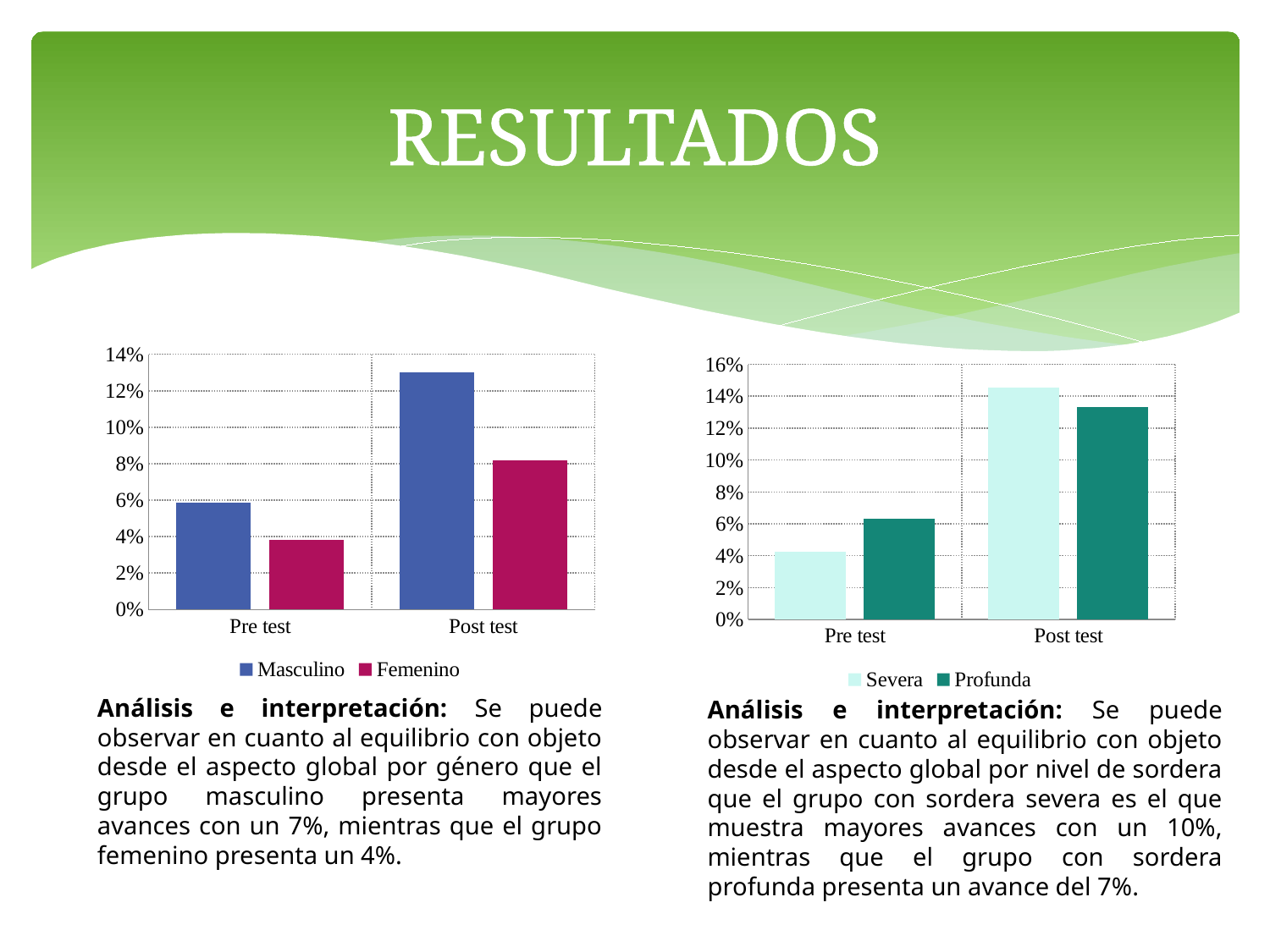
In the right chart, do the values for Severa rise or fall from Pre test to Post test? rise In the left chart, is the value for Masculino in Post test greater or less than 12%? greater In the right chart, which series has the higher value in Pre test, Severa or Profunda? Profunda In the left chart, which bar is the lowest? Femenino in Pre test In the left chart, which series has the higher value in Post test, Masculino or Femenino? Masculino What kind of chart is the left chart on the slide? bar chart What are the two series named in the legend of the right chart? Severa and Profunda In the right chart, is the value for Severa in Post test greater or less than 14%? greater In the right chart, which bar is the highest? Severa in Post test How many series does the legend of the left chart list? 2 How many categories are shown on the x axis of the right chart? 2